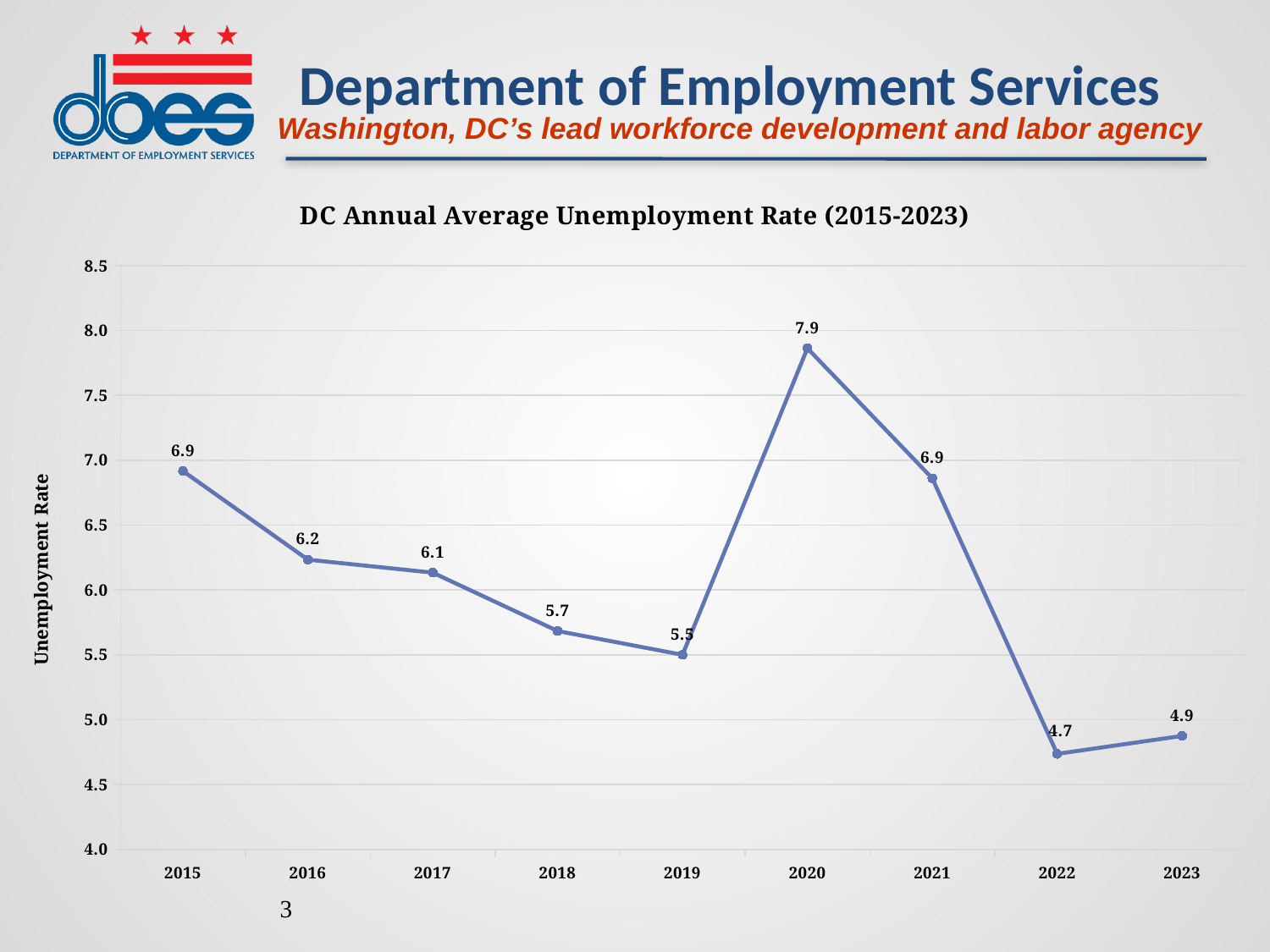
Does the unemployment rate rise or fall from 2015 to 2019? Fall How many years are plotted on the chart? 9 Which year has a higher unemployment rate, 2016 or 2018? 2016 Which year has the highest unemployment rate on the chart? 2020 What is the difference between the unemployment rate in 2020 and in 2021? 1.0 What is the unemployment rate shown for 2023? 4.9 What is the unemployment rate shown for 2019? 5.5 What is the DC annual average unemployment rate for 2020? 7.9 What is the title of the chart? DC Annual Average Unemployment Rate (2015-2023) What is the difference between the unemployment rate in 2015 and in 2019? 1.4 Which year has the lowest unemployment rate on the chart? 2022 What kind of chart is shown on the slide? Line chart